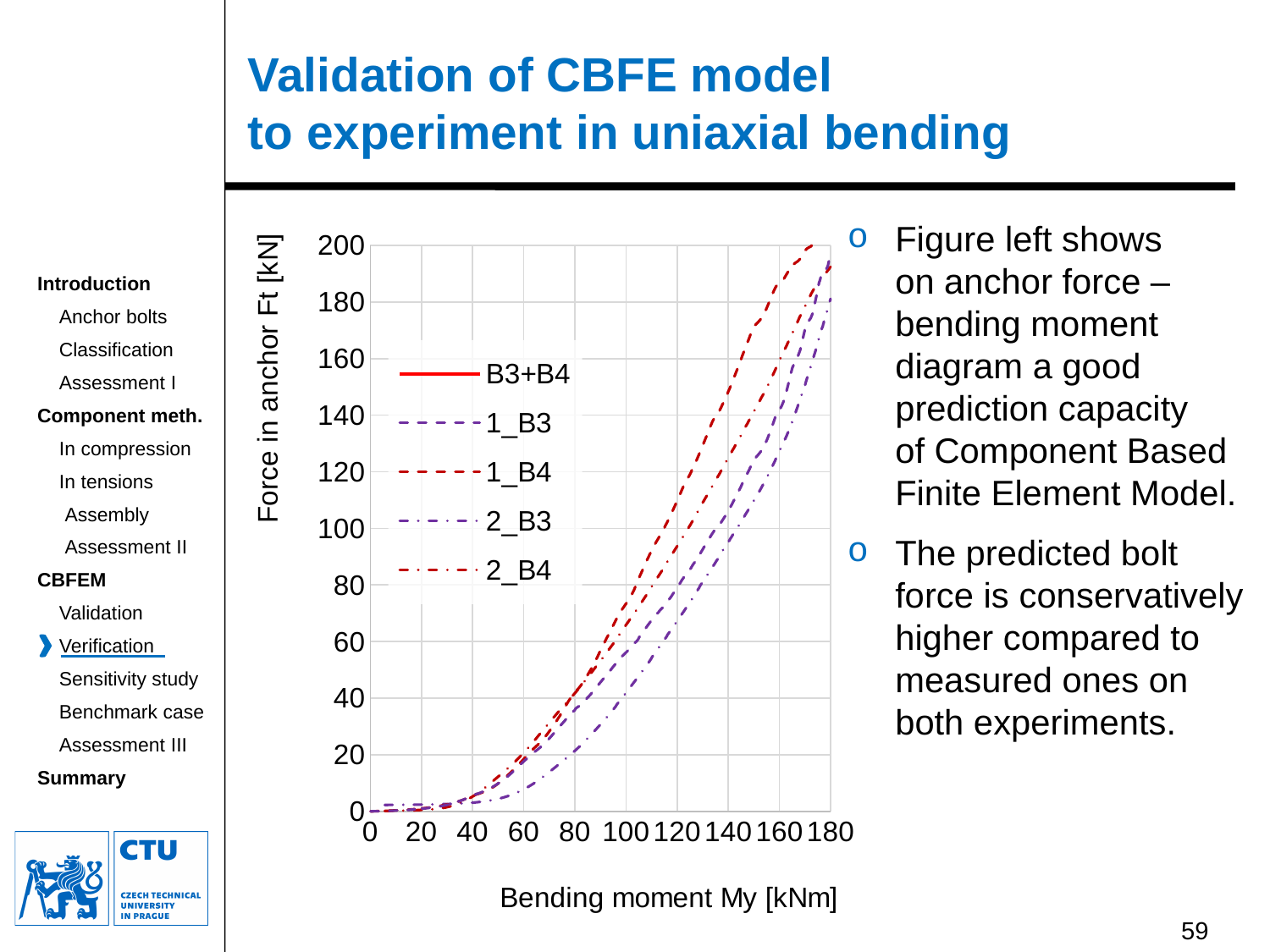
How many series does the legend list? 5 Is the value of the 2_B3 series at a bending moment of 120 kNm greater or less than 140 kN? less Is the value of the 2_B3 series at a bending moment of 60 kNm greater or less than 20 kN? less Is the value of the 1_B4 series at a bending moment of 100 kNm greater or less than 60 kN? greater Does the force in anchor rise or fall as the bending moment increases along the x axis? rise What is the label of the x axis? Bending moment My [kNm] At a bending moment of 100 kNm, which series has the larger force in anchor, 1_B4 or 2_B3? 1_B4 What kind of chart is shown on the slide? line chart What is the maximum value shown on the x axis? 180 Which series has the lowest force in anchor at a bending moment of 60 kNm? 2_B3 What is the label of the y axis? Force in anchor Ft [kN]